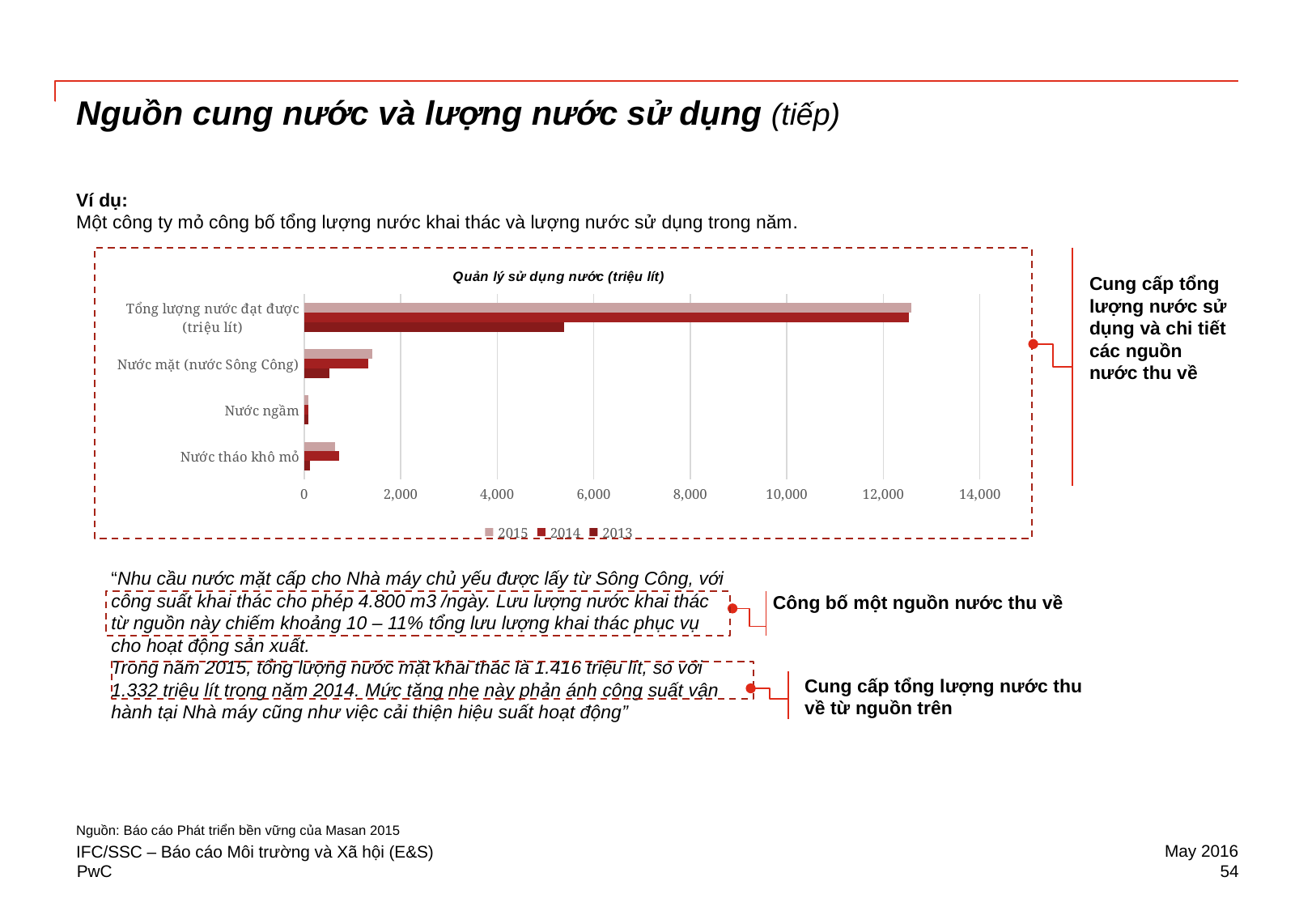
Is the 2015 value for Nước mặt (nước Sông Công) greater or less than 2,000? less Which category has the highest 2015 value? Tổng lượng nước đạt được Which category has the lowest 2015 value? Nước ngầm Is the 2013 value for Tổng lượng nước đạt được greater or less than 4,000? greater Is the 2015 value for Tổng lượng nước đạt được greater or less than 12,000? greater What is the title of the chart? Quản lý sử dụng nước (triệu lít) How many series does the chart legend list? 3 How many categories are plotted on the chart? 4 For Tổng lượng nước đạt được, which is larger: the 2013 value or the 2015 value? 2015 What kind of chart is shown on the slide? bar chart What are the series listed in the chart legend? 2015, 2014, 2013